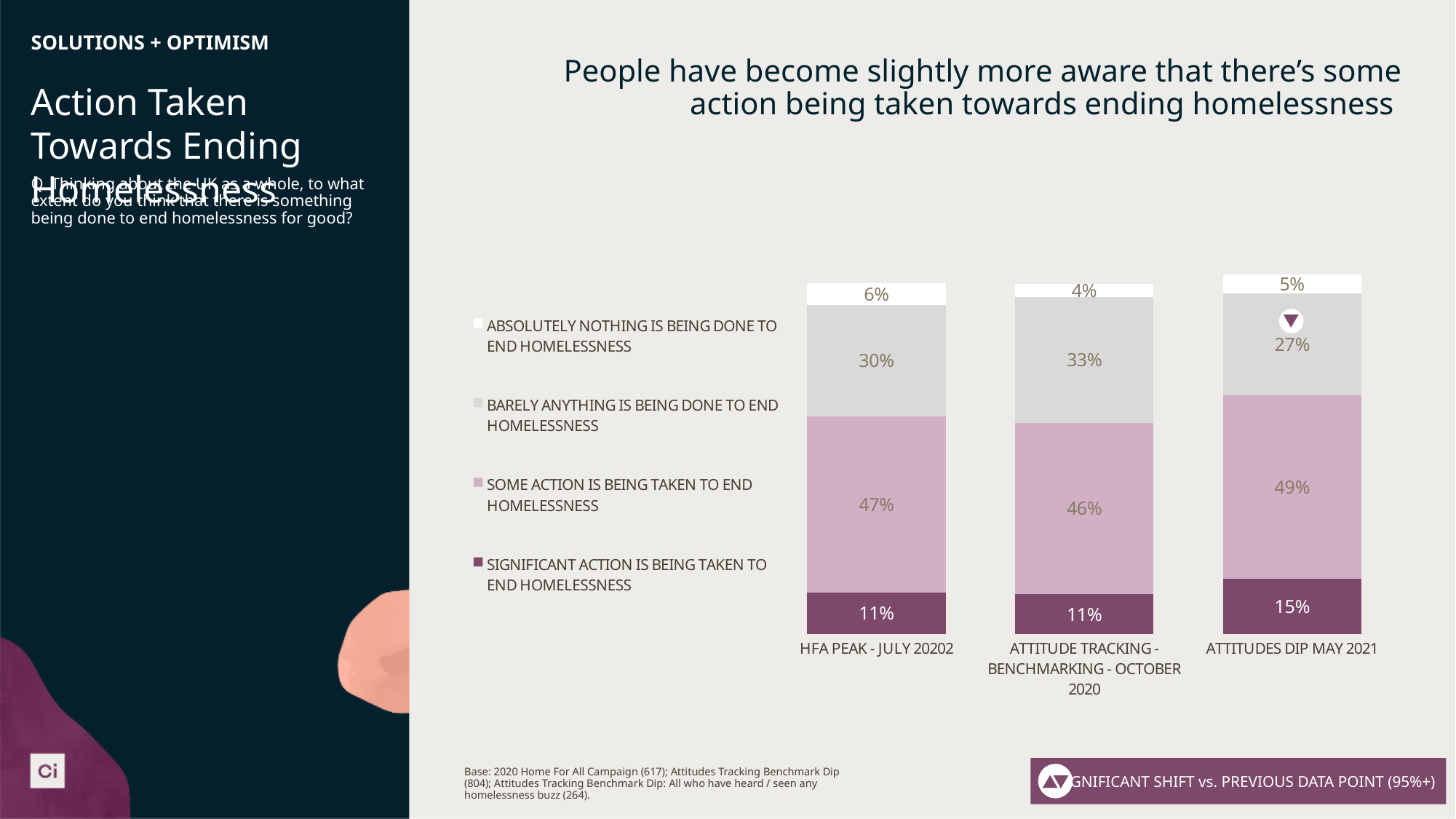
In which wave was the share saying 'Significant action is being taken to end homelessness' highest? Attitudes Dip May 2021 What is the difference in the 'Barely anything is being done' share between the October 2020 wave and the May 2021 wave? 6 percentage points What percentage said 'Significant action is being taken to end homelessness' in the HFA Peak - July 2020 wave? 11% Does the 'Significant action is being taken' share rise or fall from the October 2020 wave to the May 2021 wave? Rise What percentage said 'Absolutely nothing is being done to end homelessness' in the Attitudes Dip May 2021 wave? 5% What type of chart is shown on the slide? Stacked bar chart What percentage said 'Barely anything is being done to end homelessness' in the Attitude Tracking - Benchmarking - October 2020 wave? 33% How many survey waves (bars) are shown in the chart? 3 In which wave was the share saying 'Barely anything is being done to end homelessness' lowest? Attitudes Dip May 2021 How many response categories does the legend list? 4 What percentage said 'Some action is being taken to end homelessness' in the Attitudes Dip May 2021 wave? 49% Which is larger: the 'Some action is being taken' share in July 2020 or in October 2020? July 2020